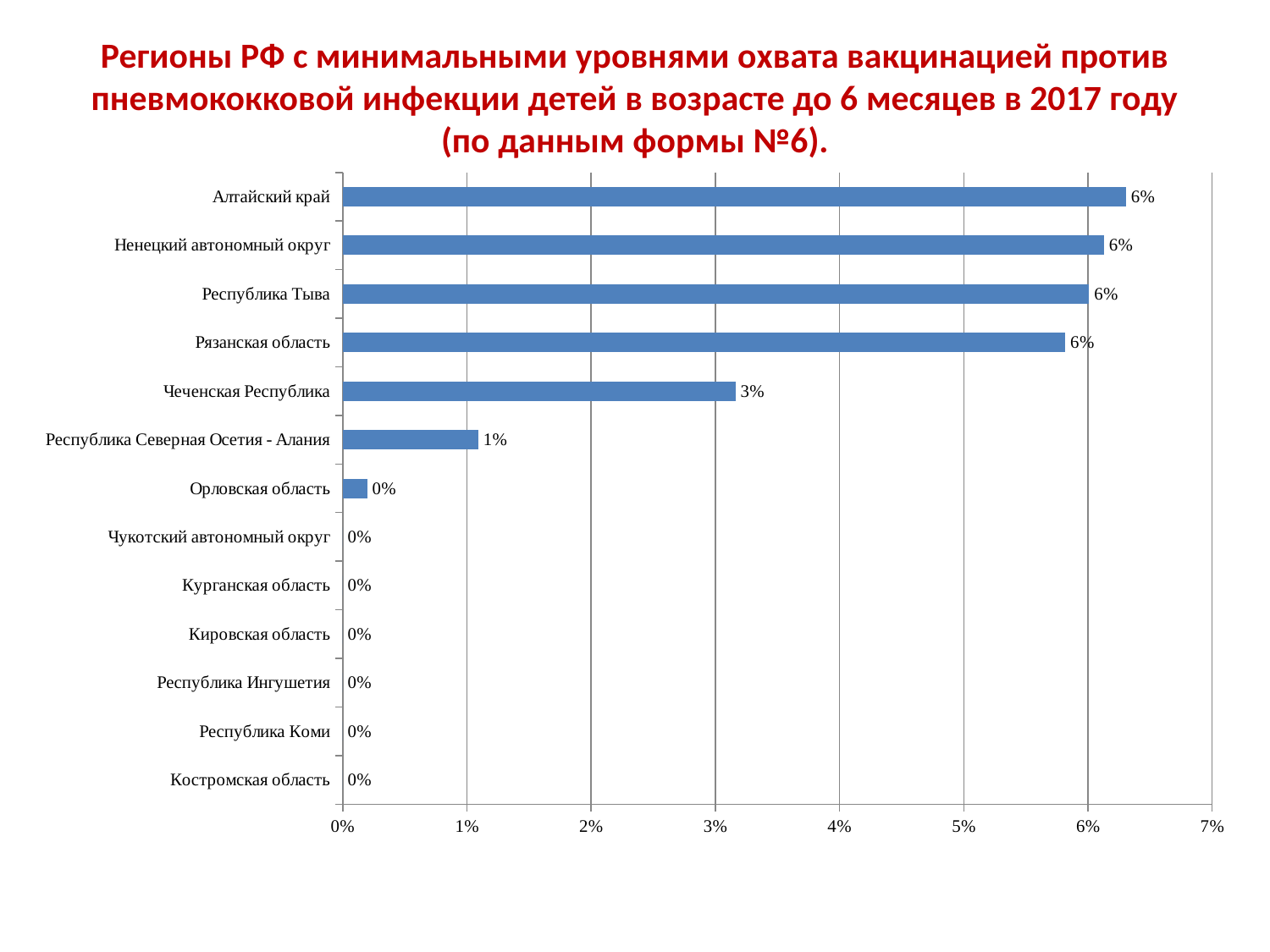
How many regions are shown on the chart? 13 What is the value shown for Орловская область? 0% Which is larger, the value for Чеченская Республика or the value for Республика Северная Осетия - Алания? Чеченская Республика What is the value shown for Чеченская Республика? 3% What kind of chart is shown on the slide? bar chart Is the value for Чеченская Республика greater or less than 2%? greater Is the value for Алтайский край greater or less than 5%? greater What is the value shown for Республика Северная Осетия - Алания? 1% What is the difference between the values for Чеченская Республика and Республика Северная Осетия - Алания? 2% Is the value for Республика Северная Осетия - Алания greater or less than 2%? less What is the value shown for Костромская область? 0% What is the value shown for Республика Тыва? 6%